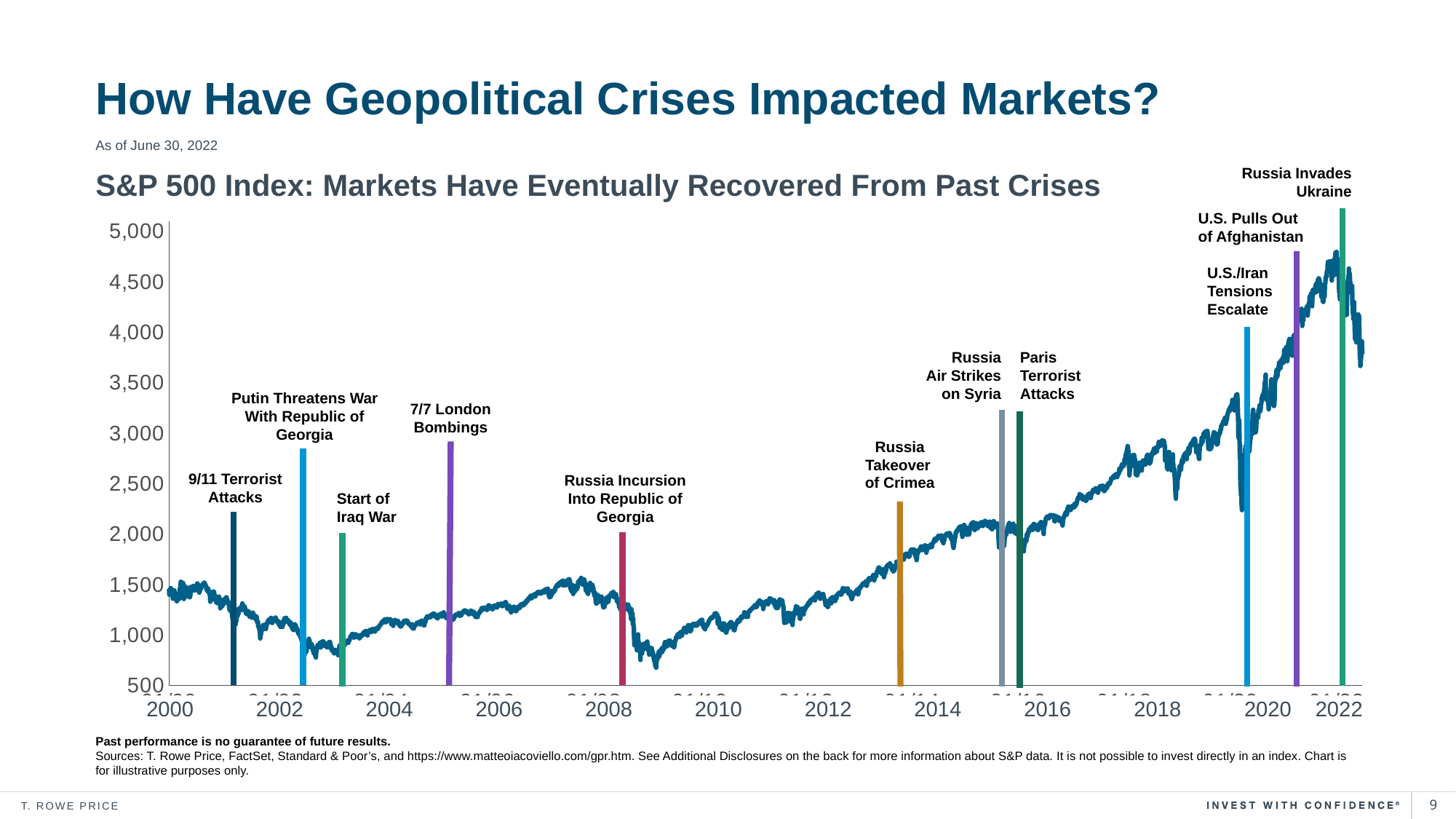
Is the S&P 500 Index value at the start of 2012 greater or less than 1,500? less Does the S&P 500 Index rise or fall between 2000 and 2002? fall Which marked event is closest to the S&P 500 Index's highest point on the chart? Russia Invades Ukraine Does the S&P 500 Index generally rise or fall between 2009 and 2021? rise Is the S&P 500 Index value at the end of the chart in 2022 greater or less than 3,500? greater What is the title of the chart? S&P 500 Index: Markets Have Eventually Recovered From Past Crises What kind of chart is shown on the slide? line chart Is the S&P 500 Index higher at the 9/11 Terrorist Attacks marker or at the Russia Invades Ukraine marker? Russia Invades Ukraine Is the S&P 500 Index value at the start of 2000 greater or less than 1,000? greater How many geopolitical crisis events are marked on the chart? 11 As of what date is the chart data shown? June 30, 2022